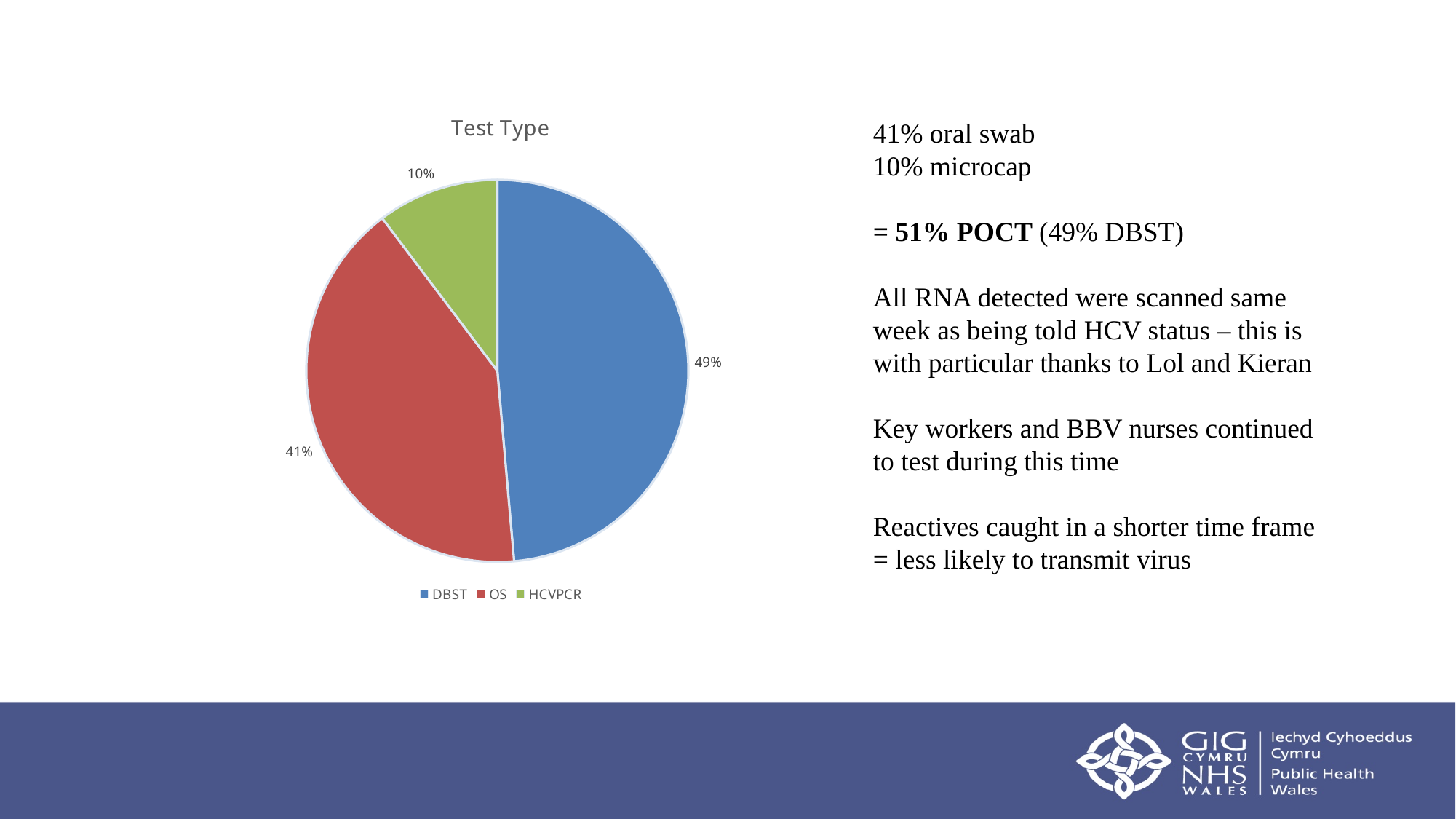
How many entries does the legend list? 3 What share of the pie does DBST take? 49% What is the title of the chart? Test Type What is the difference in percentage points between the DBST and OS slices? 8 What colour is the OS slice in the pie chart? red Which test type has the smallest slice of the pie? HCVPCR How many slices does the pie chart have? 3 What share of the pie does HCVPCR take? 10% Which slice is larger, OS or HCVPCR? OS What share of the pie does OS take? 41% Which test type has the largest slice of the pie? DBST What kind of chart is shown on the slide? pie chart